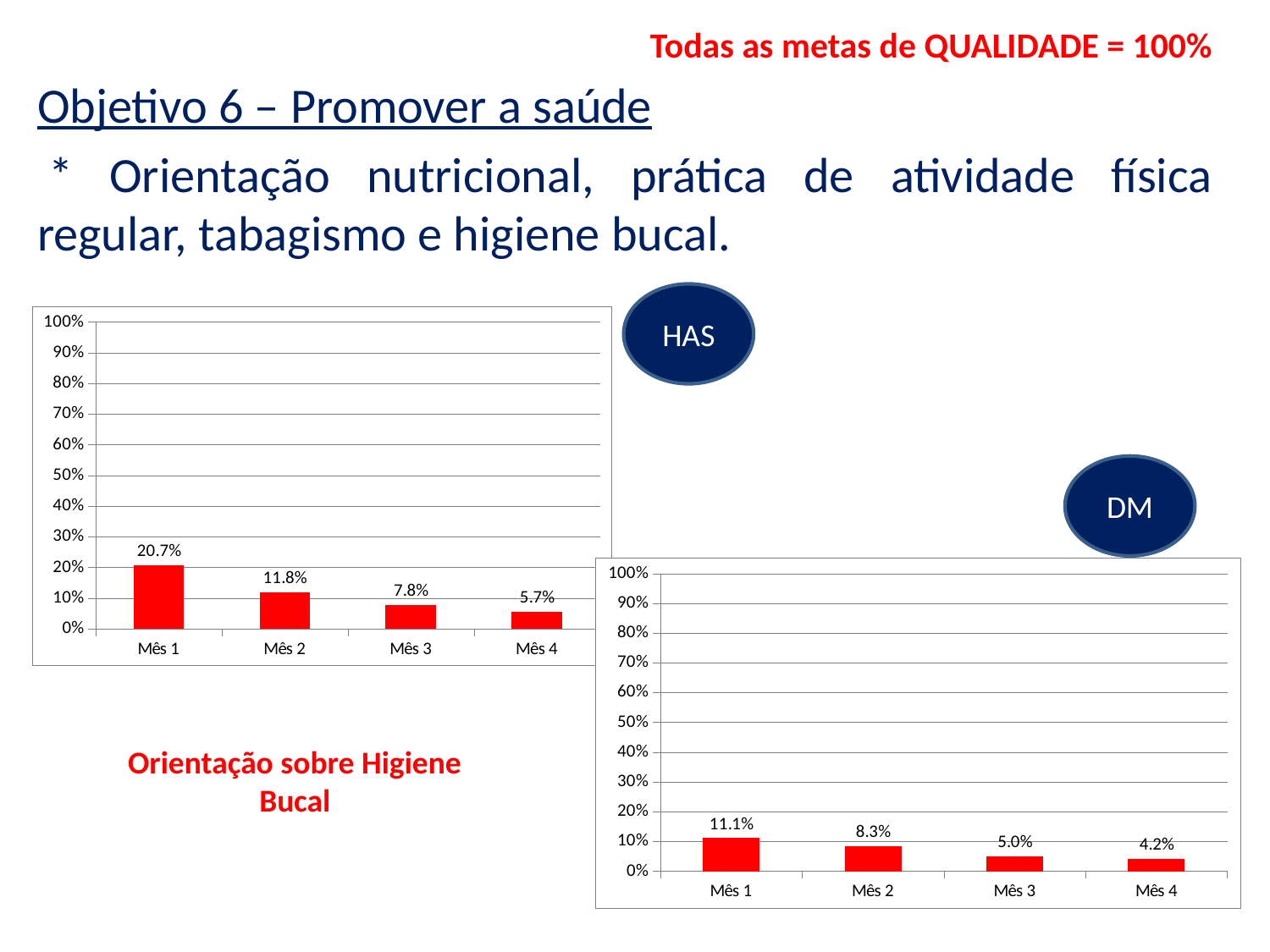
In the upper-left chart (labelled HAS), which month has the highest value? Mês 1 In the lower-right chart (labelled DM), what is the value for Mês 4? 4.2% In the lower-right chart (labelled DM), do the values rise or fall from Mês 1 to Mês 4? Fall How many months are shown on the x axis of the lower-right chart (labelled DM)? 4 What type of chart is the upper-left chart (labelled HAS)? Bar chart In the upper-left chart (labelled HAS), what is the value for Mês 1? 20.7% In the lower-right chart (labelled DM), which month has the lowest value? Mês 4 In the upper-left chart (labelled HAS), what is the difference between the values for Mês 1 and Mês 2? 8.9% In the lower-right chart (labelled DM), what is the value for Mês 2? 8.3% In the lower-right chart (labelled DM), what is the difference between the values for Mês 1 and Mês 3? 6.1% In the upper-left chart (labelled HAS), what is the value for Mês 3? 7.8% Which is larger: the Mês 2 value in the upper-left chart (HAS) or the Mês 1 value in the lower-right chart (DM)? Mês 2 in the HAS chart (11.8%)